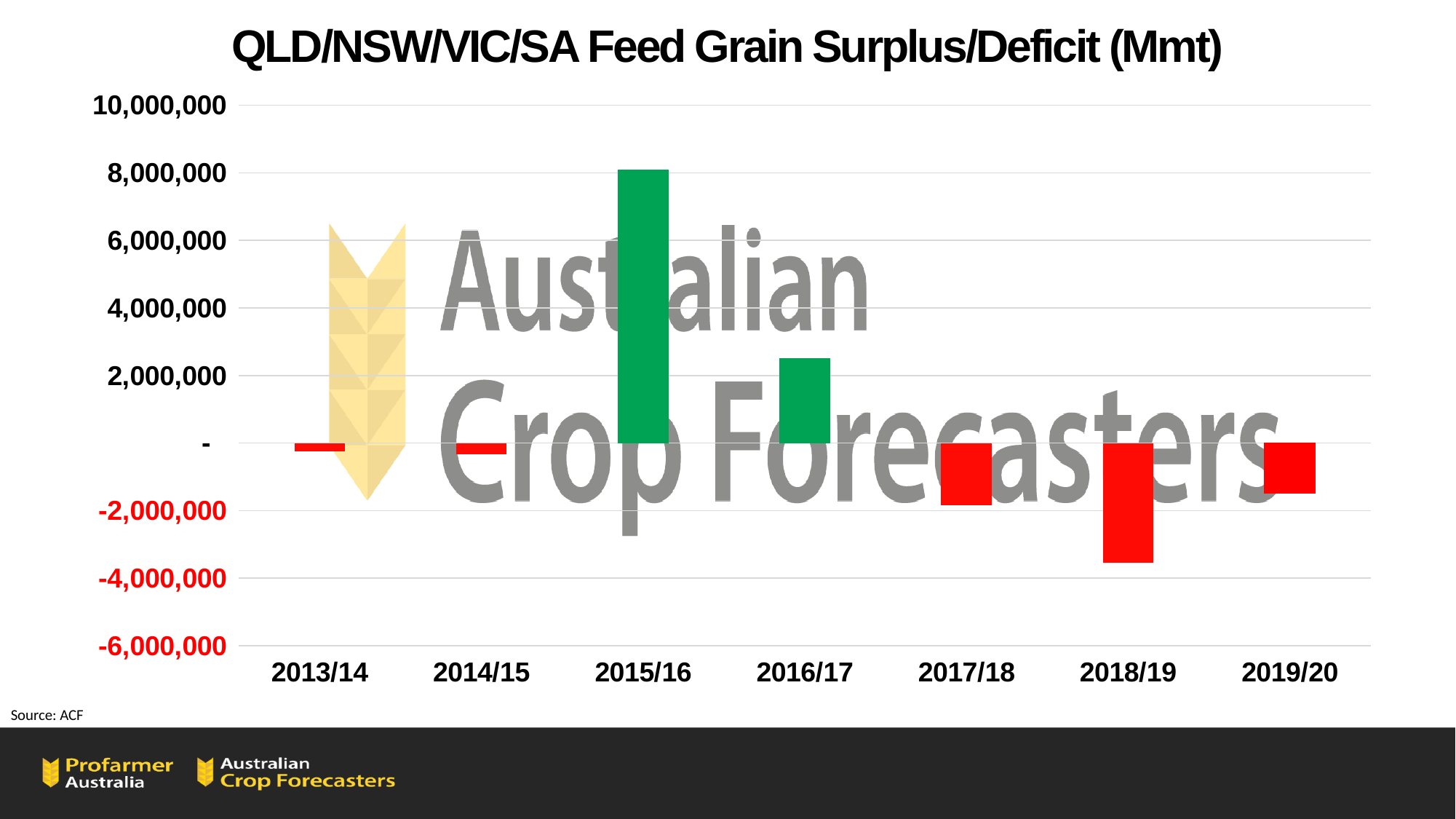
Is the value for 2019/20 greater or less than -2,000,000? greater Which is larger, the value for 2015/16 or the value for 2016/17? 2015/16 How many seasons (categories) are shown on the x axis? 7 Is the value for 2018/19 greater or less than -2,000,000? less Which season has the lowest value (largest deficit)? 2018/19 What type of chart is shown on the slide? Bar chart What is the title of the chart? QLD/NSW/VIC/SA Feed Grain Surplus/Deficit (Mmt) Is the value for 2015/16 greater or less than 6,000,000? greater How many seasons show a deficit (negative value)? 5 Which season has the highest feed grain surplus? 2015/16 Which is larger, the value for 2018/19 or the value for 2019/20? 2019/20